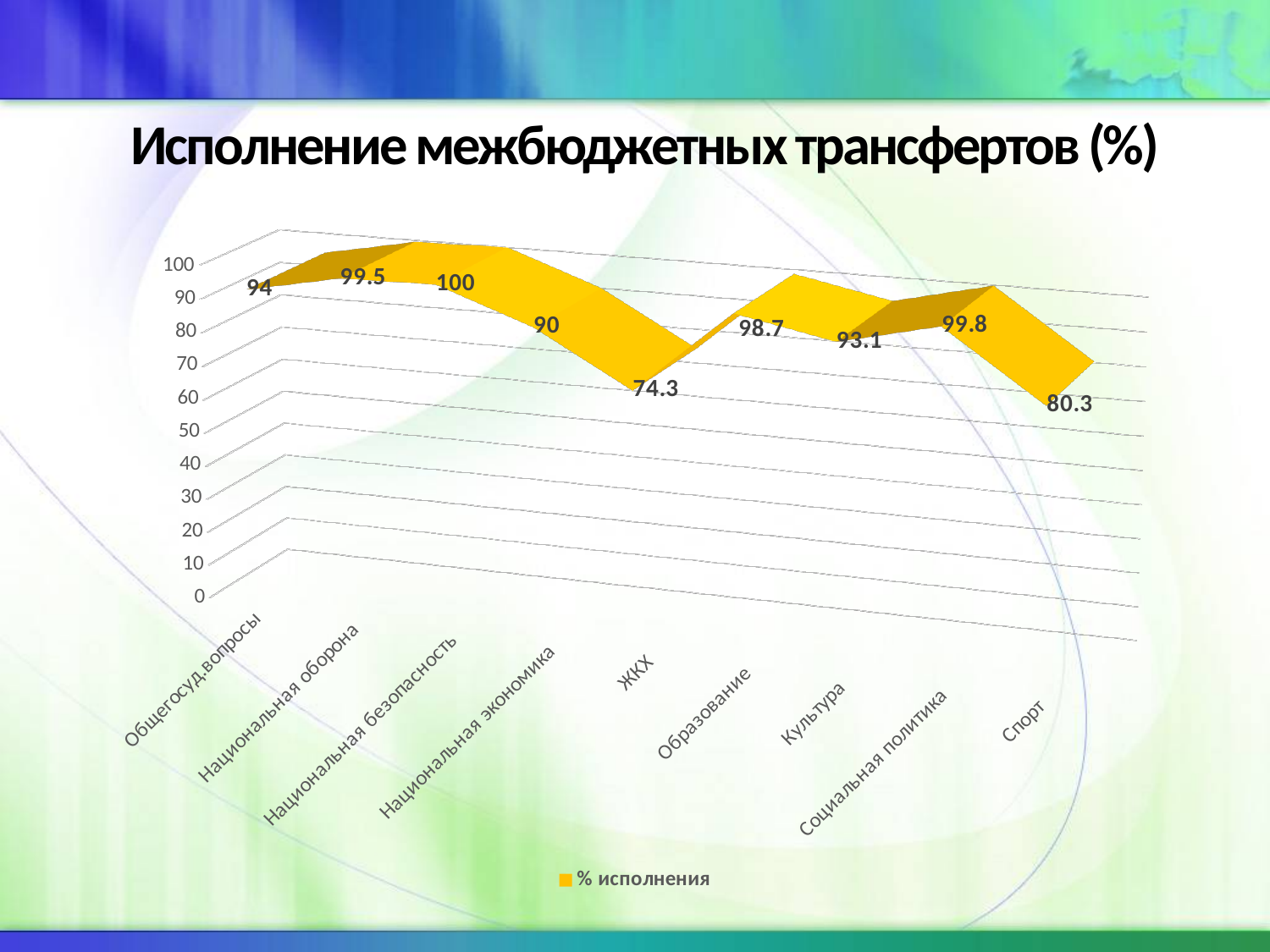
What kind of chart is shown on the slide? line chart How many series does the legend list? 1 How many categories are shown on the x axis? 9 What is the title of the chart? Исполнение межбюджетных трансфертов (%) Which category has the highest value? Национальная безопасность What is the value for Социальная политика? 99.8 Which is larger, the value for Общегосуд.вопросы or the value for Спорт? Общегосуд.вопросы Which category has the lowest value? ЖКХ What is the value for Спорт? 80.3 What is the value for Национальная экономика? 90 What is the value for ЖКХ? 74.3 What is the difference between the values for Образование and Культура? 5.6